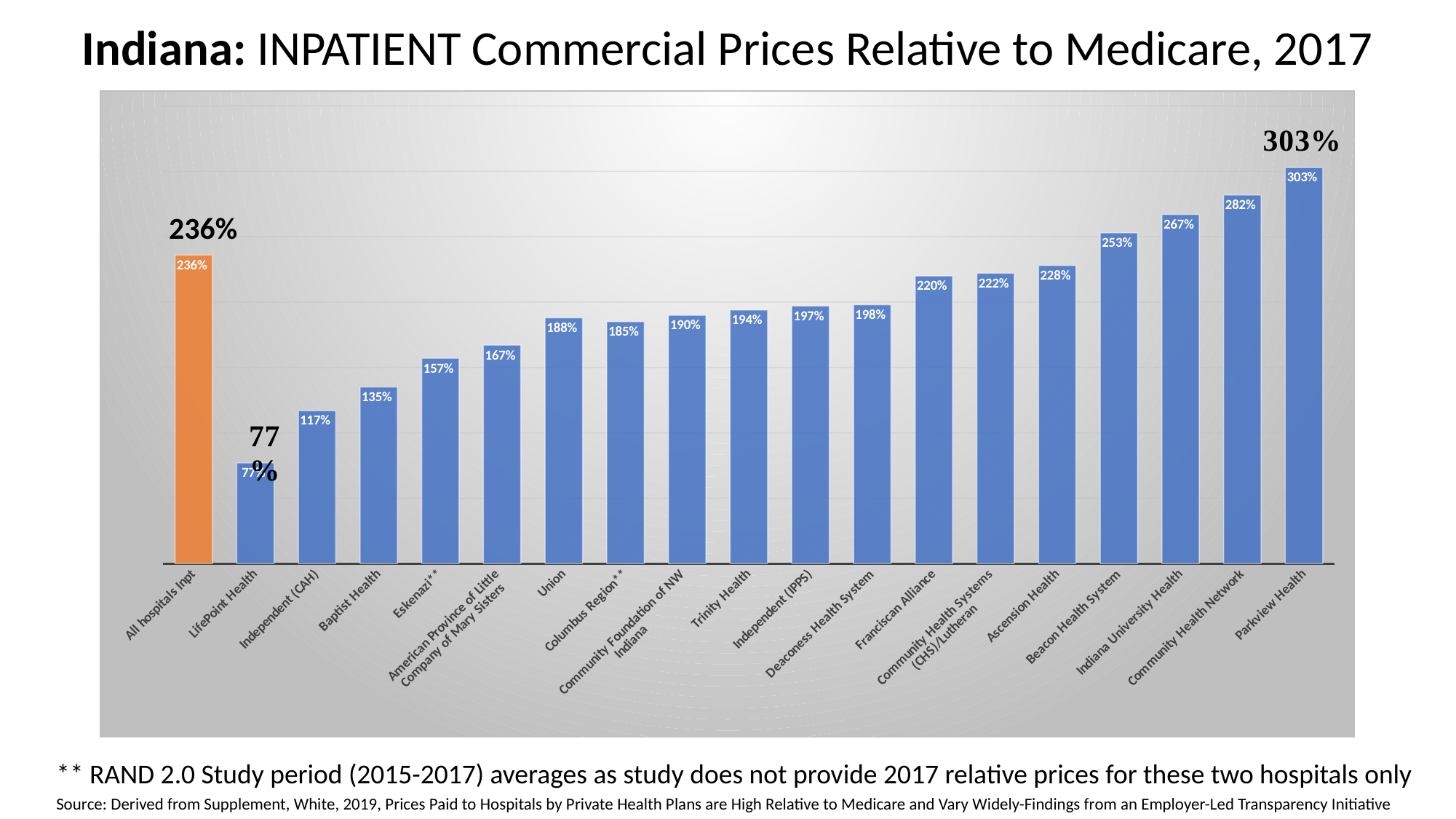
What is the difference between the values for Beacon Health System and Ascension Health? 25% What is the value for All hospitals Inpt? 236% What is the difference between the values for Parkview Health and Community Health Network? 21% Which bar is coloured orange rather than blue? All hospitals Inpt What is the value for Indiana University Health? 267% What is the value for Parkview Health? 303% How many bars are shown in the chart? 19 What is the value for LifePoint Health? 77% What kind of chart is shown on the slide? Bar chart Which is larger, the value for Union or the value for Columbus Region**? Union Which category has the highest value? Parkview Health Which category has the lowest value? LifePoint Health